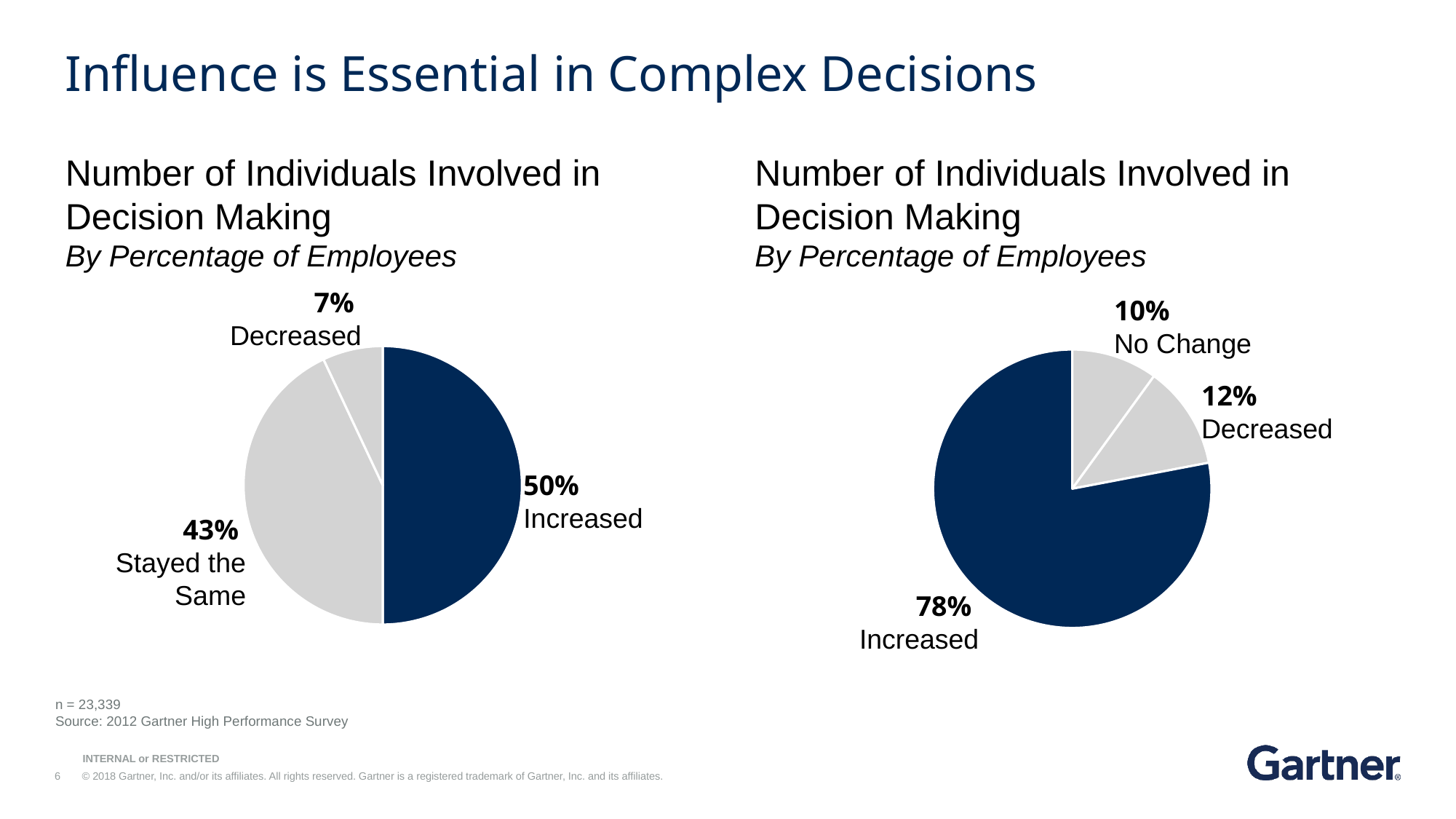
In the right pie chart, which is larger: Decreased or No Change? Decreased In the left pie chart, what percentage is labelled Stayed the Same? 43% In the right pie chart, what percentage of employees said the number of individuals involved in decision making Increased? 78% In the right pie chart, which category has the largest slice? Increased In the left pie chart, what percentage is labelled Decreased? 7% In the left pie chart, what is the difference between the Increased and Stayed the Same percentages? 7% In the left pie chart, which category has the smallest slice? Decreased In the left pie chart, what percentage of employees said the number of individuals involved in decision making Increased? 50% What type of chart is shown on the left side of the slide? Pie chart How many slices does the right pie chart have? 3 In the right pie chart, what percentage is labelled Decreased? 12% In the right pie chart, what percentage is labelled No Change? 10%